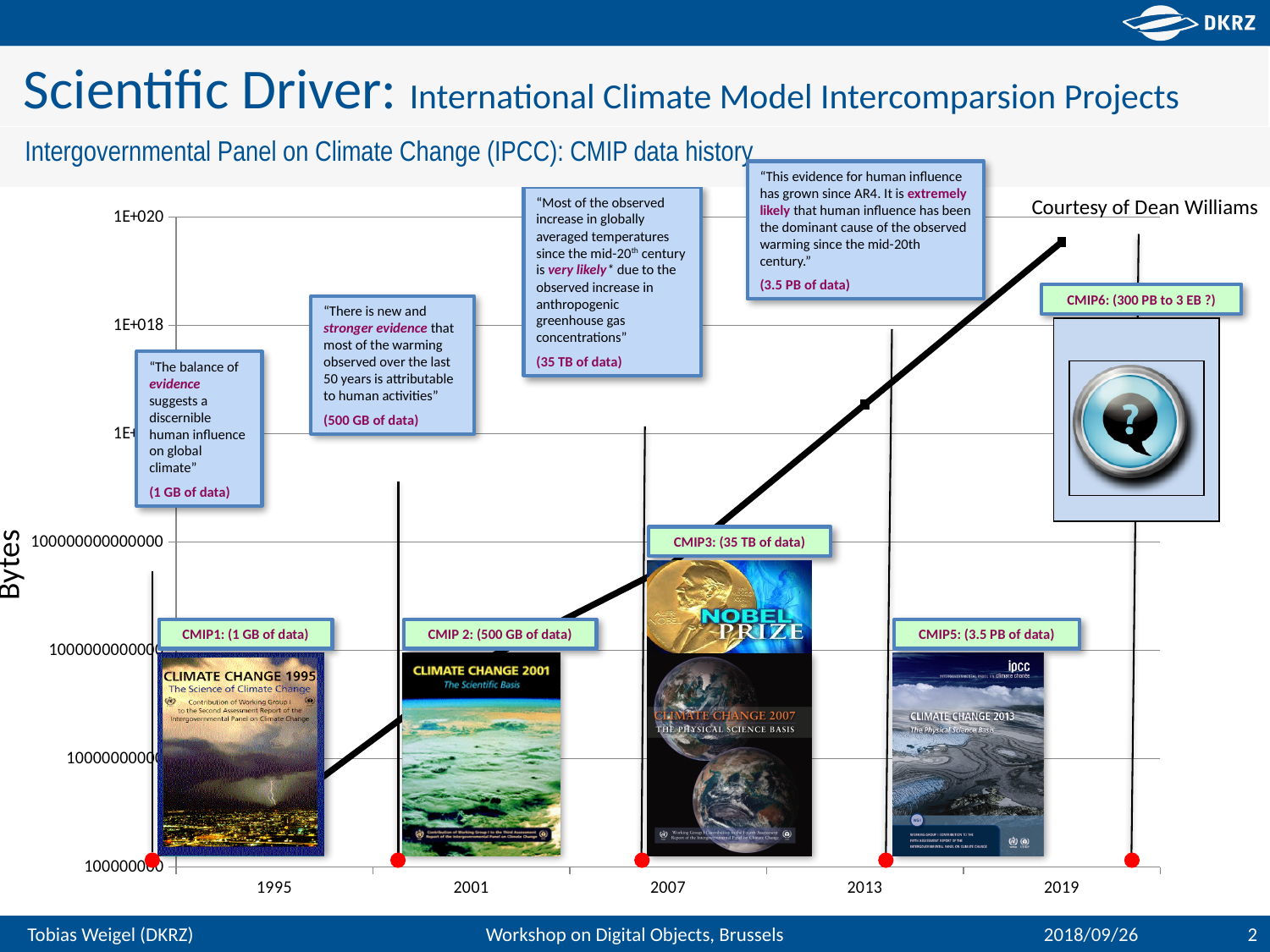
What data volume is given for CMIP1 on the chart? 1 GB Is the plotted value for 2013 greater or less than 1E+018 bytes? less What kind of chart is used to show the CMIP data history? line chart What data volume is given for CMIP3 on the chart? 35 TB Do the plotted data volumes rise or fall from 1995 to 2019? rise How many years are labeled on the x axis of the chart? 5 What data volume range is given for CMIP6 on the chart? 300 PB to 3 EB What is the label of the y axis of the chart? Bytes Which CMIP phase has the smallest data volume shown on the chart? CMIP1 Which has the larger data volume, CMIP 2 or CMIP3? CMIP3 What data volume is given for CMIP 2 on the chart? 500 GB What data volume is given for CMIP5 on the chart? 3.5 PB